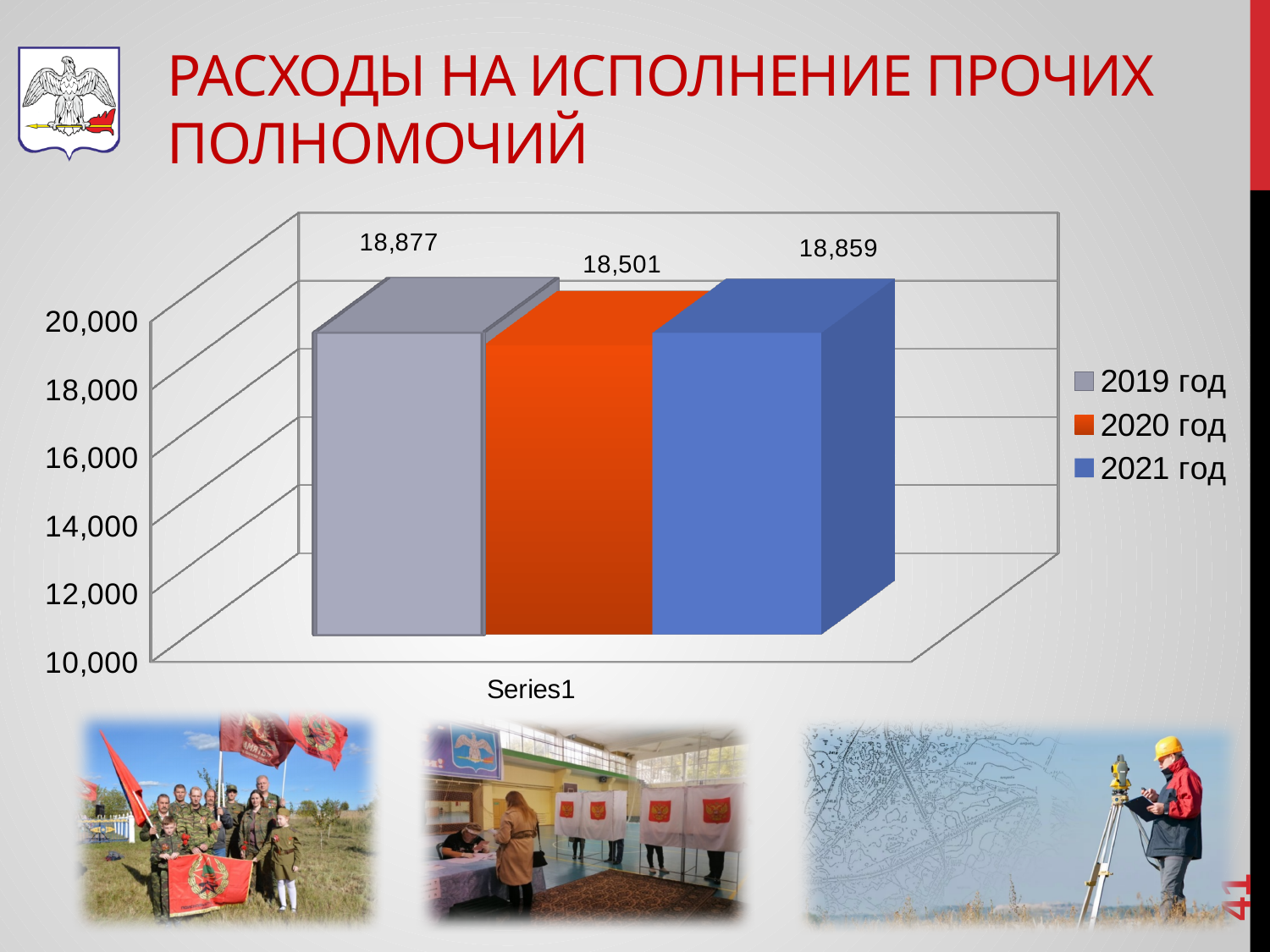
What is the difference between the values for 2019 год and 2020 год? 376 What is the value for 2021 год? 18,859 What is the value for 2019 год? 18,877 What kind of chart is shown on the slide? bar chart How many entries does the legend list? 3 What is the difference between the values for 2021 год and 2020 год? 358 Which year has the highest value? 2019 год Which year has the lowest value? 2020 год Is the value for 2020 год greater or less than 18,000? greater What is the value for 2020 год? 18,501 Which is larger, the value for 2019 год or the value for 2021 год? 2019 год How many bars are shown in the chart? 3